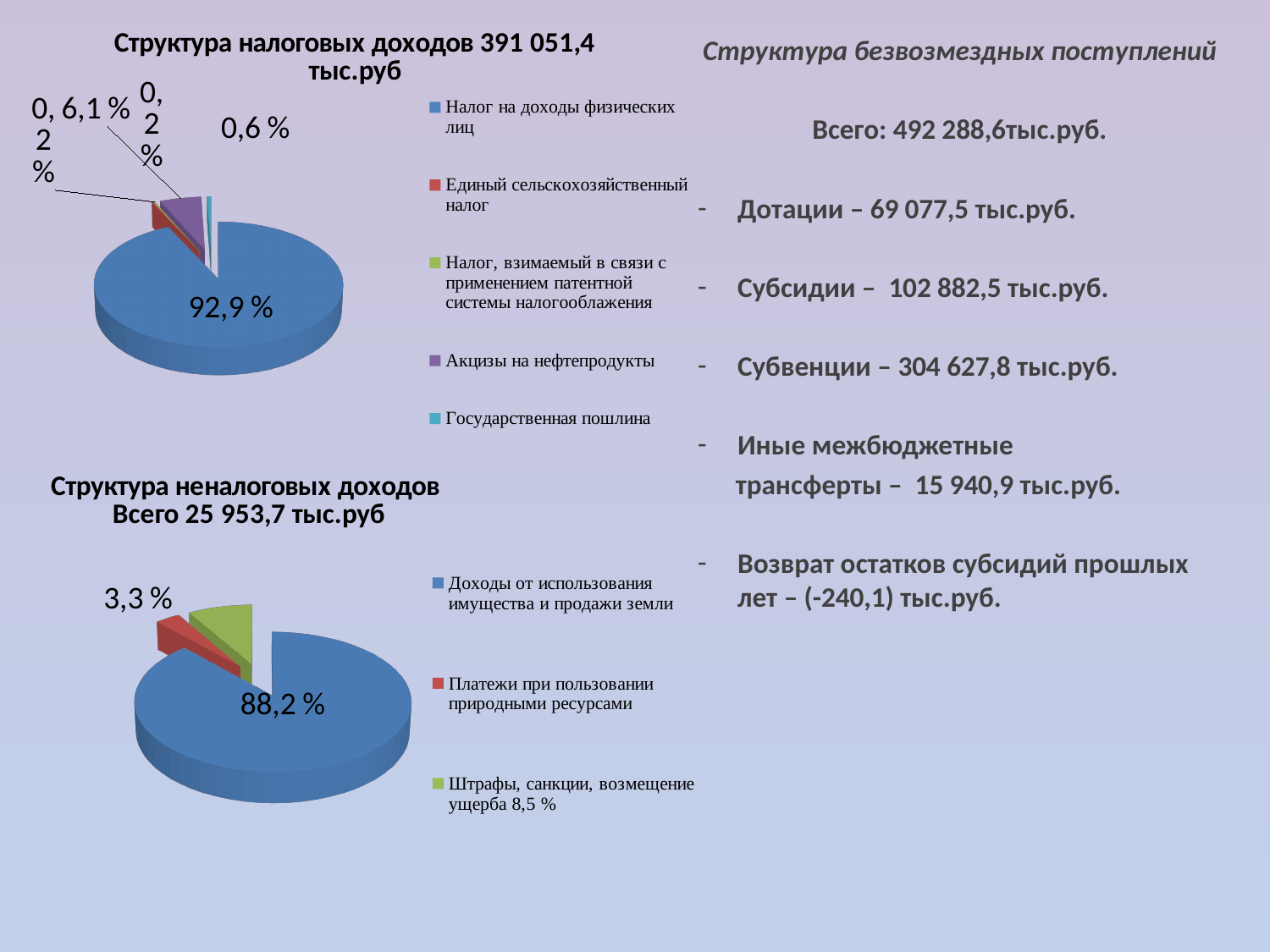
What kind of chart is the top-left chart titled 'Структура налоговых доходов'? pie chart In the top-left chart 'Структура налоговых доходов', which category has the largest slice? Налог на доходы физических лиц What kind of chart is the bottom-left chart titled 'Структура неналоговых доходов'? pie chart How many entries does the legend of the bottom-left chart 'Структура неналоговых доходов' list? 3 In the bottom-left chart 'Структура неналоговых доходов', what share is shown for 'Доходы от использования имущества и продажи земли'? 88,2 % In the bottom-left chart 'Структура неналоговых доходов', what is the difference in percentage points between the 88,2 % slice and the 3,3 % slice? 84,9 How many entries does the legend of the top-left chart 'Структура налоговых доходов' list? 5 What total amount is stated in the title of the bottom-left chart 'Структура неналоговых доходов'? 25 953,7 тыс.руб In the bottom-left chart 'Структура неналоговых доходов', which category has the smallest slice? Платежи при пользовании природными ресурсами In the top-left chart 'Структура налоговых доходов', what share is shown for the largest slice? 92,9 % In the bottom-left chart 'Структура неналоговых доходов', which is larger: the slice for 'Доходы от использования имущества и продажи земли' or the slice for 'Штрафы, санкции, возмещение ущерба'? Доходы от использования имущества и продажи земли In the bottom-left chart 'Структура неналоговых доходов', what share is shown for 'Платежи при пользовании природными ресурсами'? 3,3 %